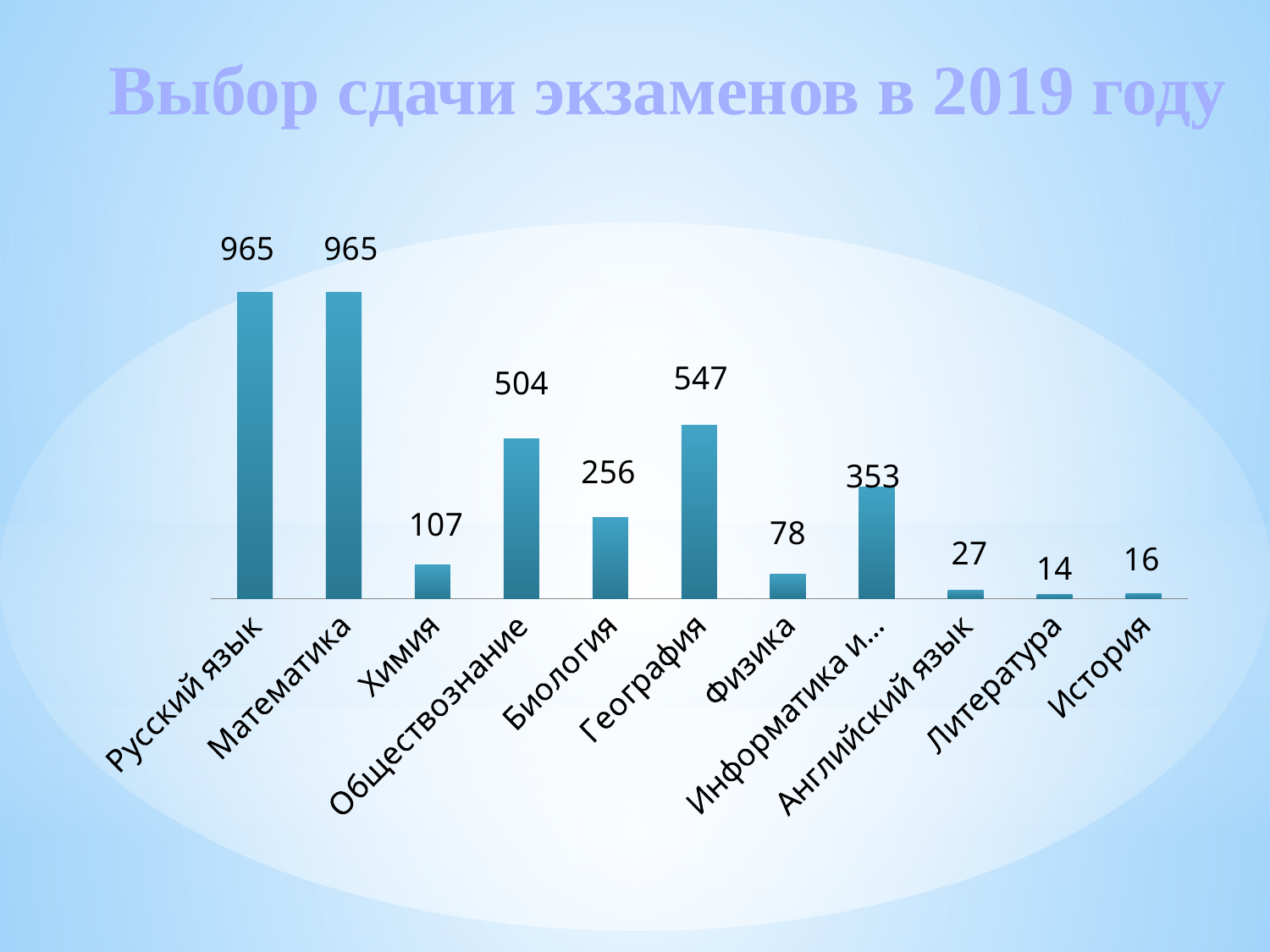
What type of chart is shown on the slide? bar chart What is the value for Обществознание? 504 What is the title of the slide? Выбор сдачи экзаменов в 2019 году Which is larger, the value for Биология or the value for Физика? Биология What is the difference between the values for География and Обществознание? 43 What is the value for Английский язык? 27 How many categories are shown in the chart? 11 Which is larger, the value for История or the value for Литература? История What is the difference between the values for Русский язык and Химия? 858 What is the value for Биология? 256 What is the value for География? 547 Which category has the lowest value? Литература